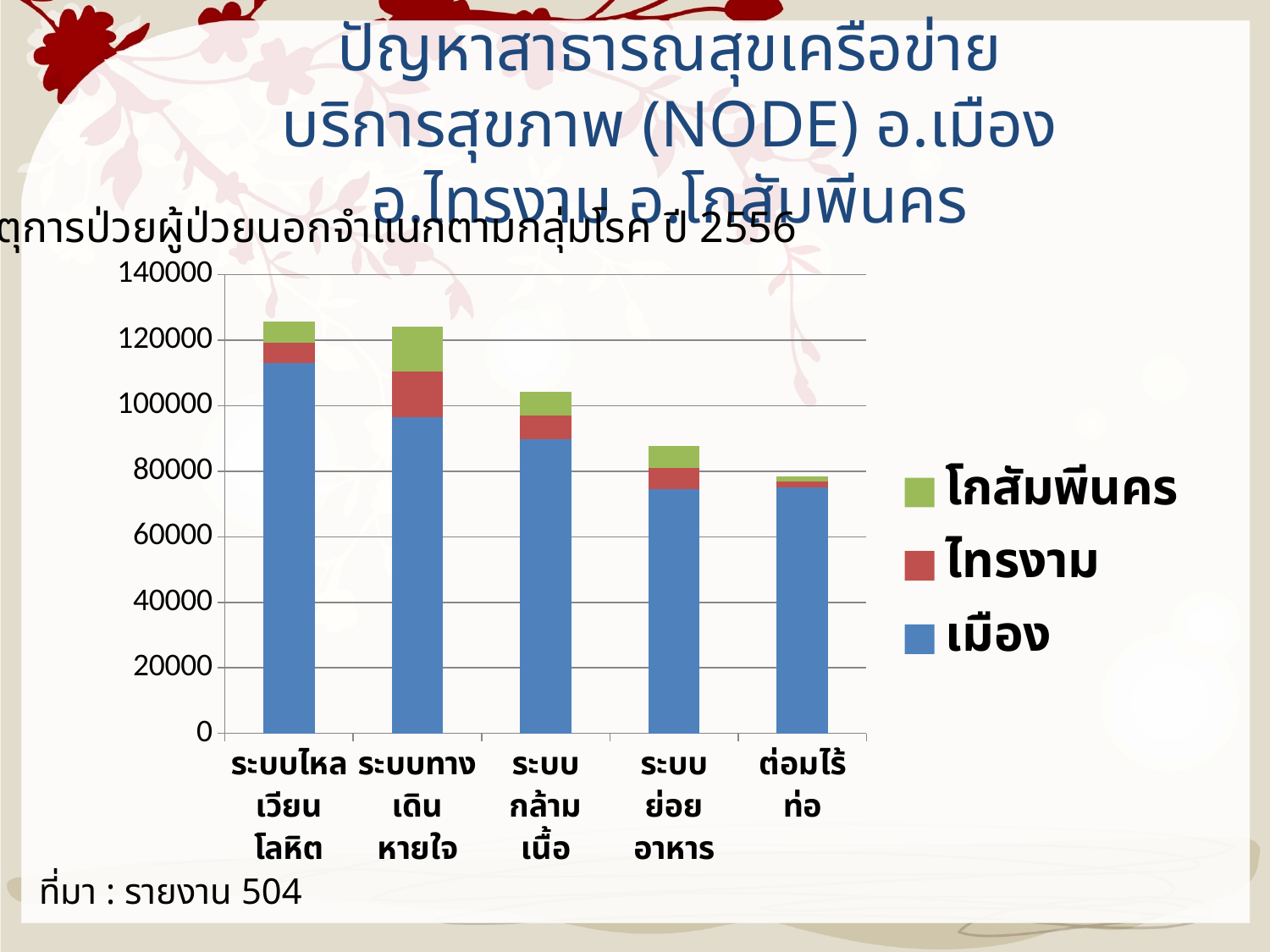
Which category has the lowest total stacked bar? ต่อมไร้ท่อ Which has the larger total stacked bar, ระบบกล้ามเนื้อ or ระบบย่อยอาหาร? ระบบกล้ามเนื้อ Which colour represents the เมือง series in the chart? Blue Is the เมือง value for ระบบทางเดินหายใจ greater or less than 100000? less Is the เมือง value for ระบบไหลเวียนโลหิต greater or less than 100000? greater Which category has the highest value for the เมือง series? ระบบไหลเวียนโลหิต Do the total stacked values rise or fall moving from left to right along the x axis? Fall How many disease-group categories are shown on the x axis? 5 Is the total stacked value for ระบบย่อยอาหาร greater or less than 100000? less What kind of chart is shown on the slide? Stacked bar chart How many series does the legend list? 3